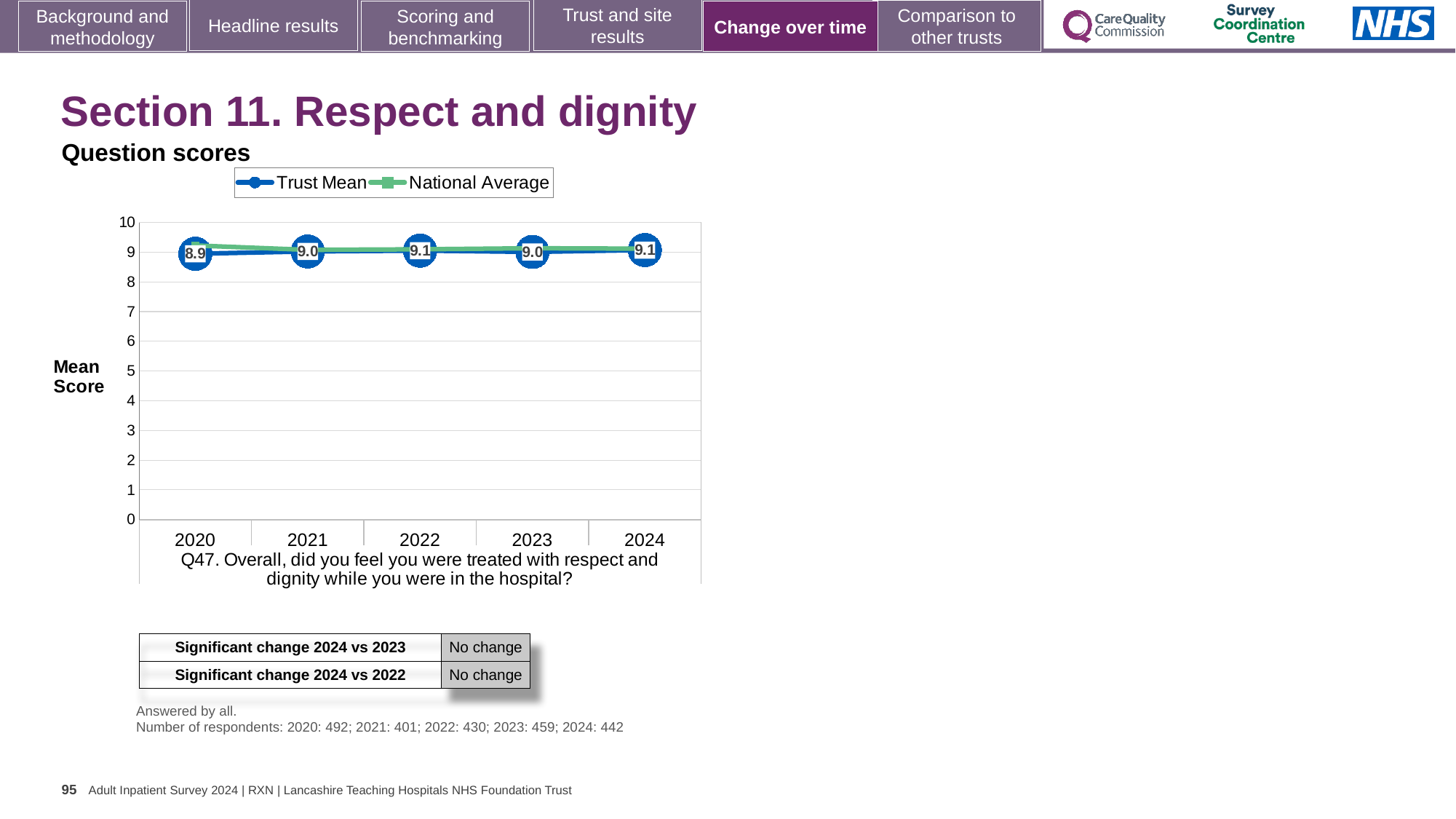
Which is larger, the Trust Mean score for 2020 or for 2021? 2021 How many years are plotted on the x axis? 5 What is the Trust Mean score for 2022? 9.1 Is the National Average value for 2020 greater or less than 8? greater In which year is the Trust Mean score lowest? 2020 Does the Trust Mean score rise or fall from 2020 to 2024? Rise What is the Trust Mean score for 2020? 8.9 What are the two series named in the legend? Trust Mean and National Average How many series does the legend list? 2 What is the difference between the Trust Mean score in 2024 and in 2020? 0.2 What is the Trust Mean score for 2023? 9.0 What kind of chart is shown on the slide? Line chart